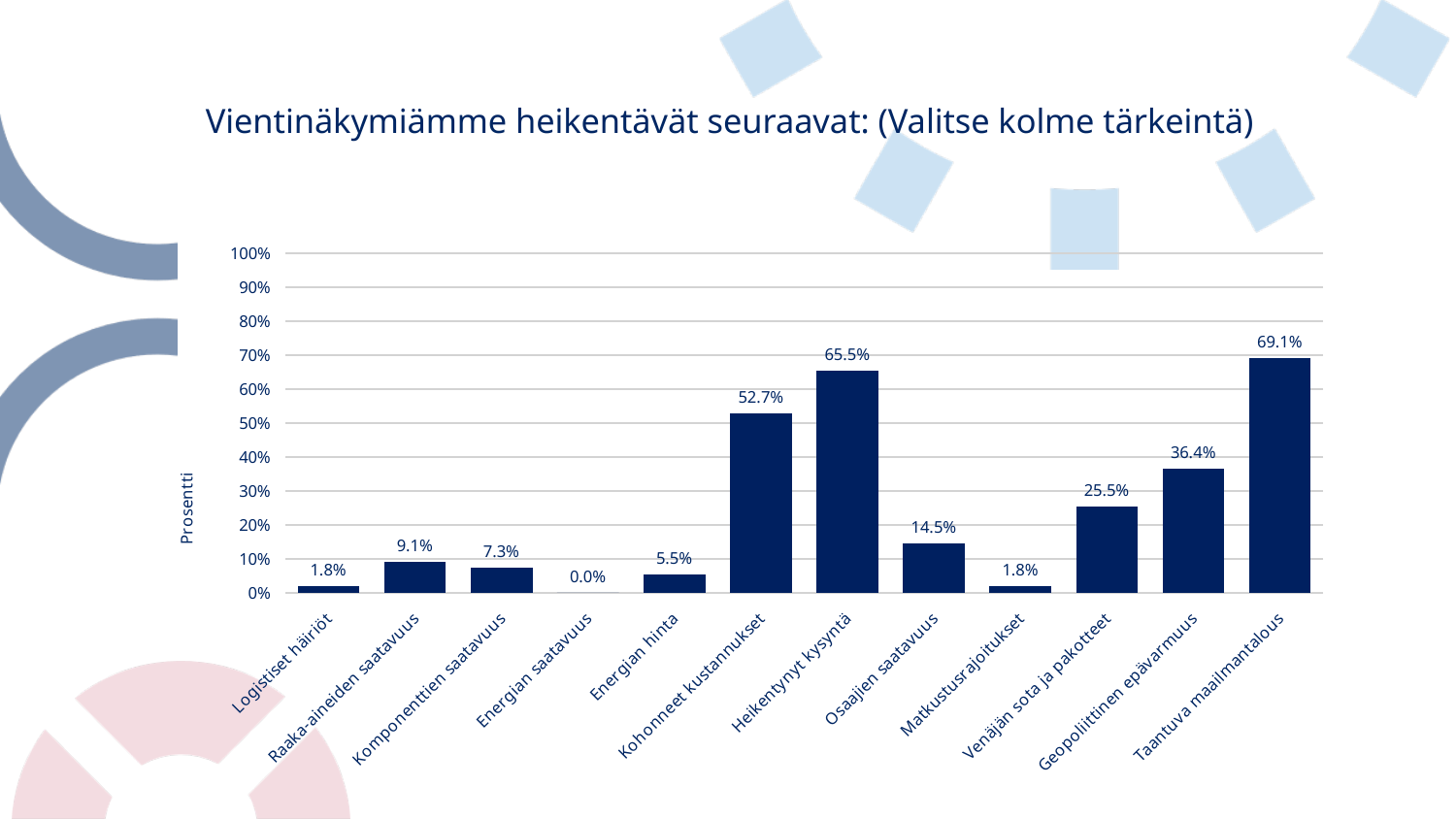
What is the label of the vertical axis? Prosentti Which category has the lowest value? Energian saatavuus What is the difference between Taantuva maailmantalous and Heikentynyt kysyntä? 3.6% Which is larger, Kohonneet kustannukset or Geopoliittinen epävarmuus? Kohonneet kustannukset What kind of chart is shown on the slide? Bar chart What is the value for Energian saatavuus? 0.0% What is the difference between Geopoliittinen epävarmuus and Venäjän sota ja pakotteet? 10.9% How many categories are shown on the x axis? 12 Which category has the highest value? Taantuva maailmantalous What is the value for Heikentynyt kysyntä? 65.5% What is the value for Venäjän sota ja pakotteet? 25.5% Is the value for Osaajien saatavuus greater or less than 20%? less